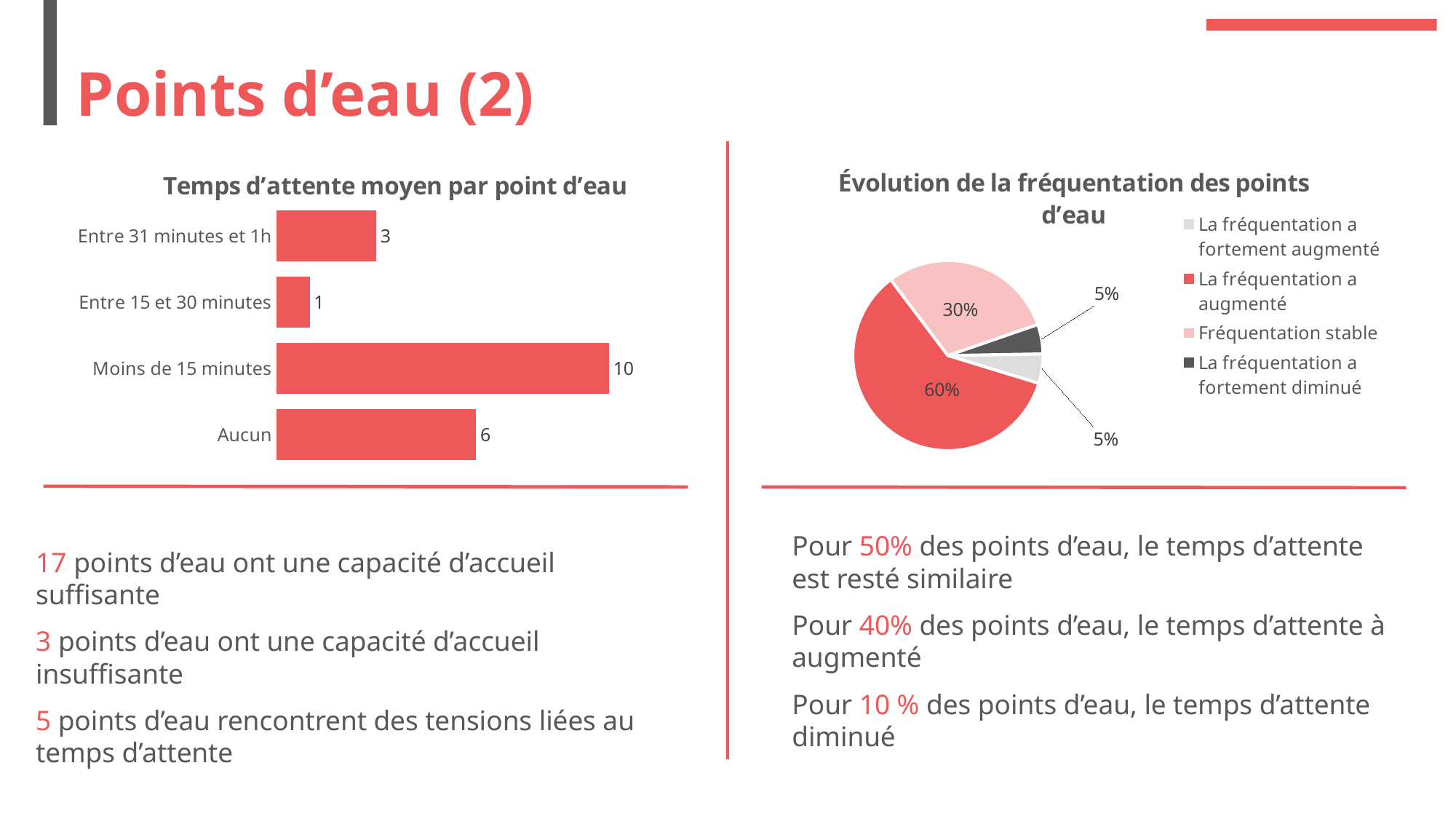
How many categories are shown in the chart 'Temps d'attente moyen par point d'eau'? 4 What kind of chart is 'Temps d'attente moyen par point d'eau'? Bar chart In the chart 'Temps d'attente moyen par point d'eau', what is the value for 'Entre 15 et 30 minutes'? 1 In the chart 'Temps d'attente moyen par point d'eau', which category has the lowest value? Entre 15 et 30 minutes In the chart 'Temps d'attente moyen par point d'eau', which category has the highest value? Moins de 15 minutes In the chart 'Temps d'attente moyen par point d'eau', which is larger: 'Aucun' or 'Entre 31 minutes et 1h'? Aucun In the chart 'Temps d'attente moyen par point d'eau', what is the difference between the values for 'Aucun' and 'Entre 31 minutes et 1h'? 3 In the chart 'Temps d'attente moyen par point d'eau', what is the value for 'Moins de 15 minutes'? 10 How many entries does the legend of the chart 'Évolution de la fréquentation des points d'eau' list? 4 In the chart 'Évolution de la fréquentation des points d'eau', what share does 'La fréquentation a augmenté' have? 60% What kind of chart is 'Évolution de la fréquentation des points d'eau'? Pie chart In the chart 'Évolution de la fréquentation des points d'eau', what share does 'Fréquentation stable' have? 30%